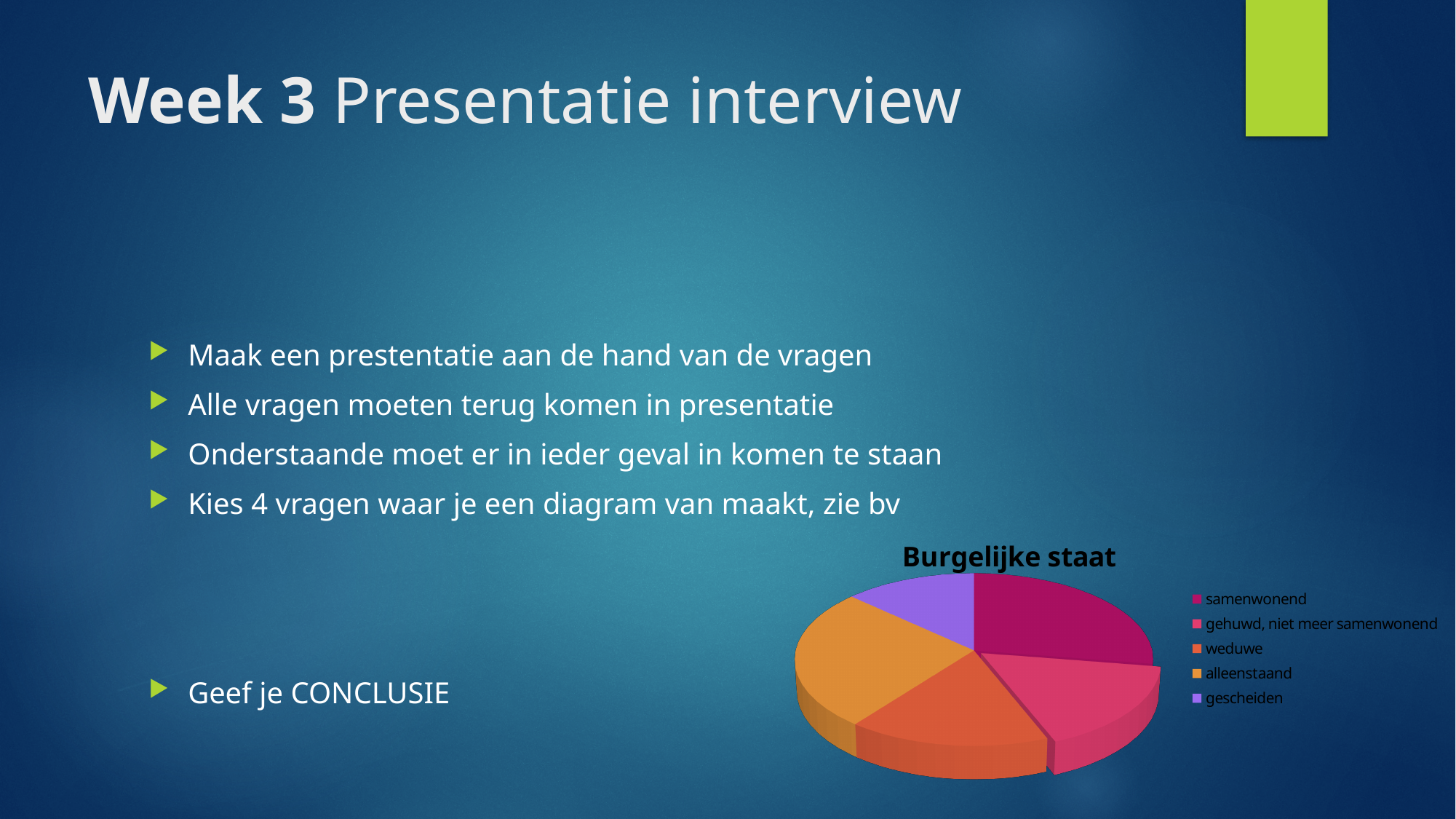
What is the title of the chart on the slide? Burgelijke staat Which slice is larger in the pie chart, samenwonend or gescheiden? samenwonend Which category has the smallest slice in the pie chart? gescheiden Which slice is larger in the pie chart, alleenstaand or gescheiden? alleenstaand Which slice is larger in the pie chart, weduwe or gescheiden? weduwe Which legend entry is listed first in the pie chart's legend? samenwonend Which category is shown in purple in the pie chart? gescheiden What kind of chart is shown on the slide? pie chart How many entries does the legend of the pie chart list? 5 How many categories (slices) does the pie chart have? 5